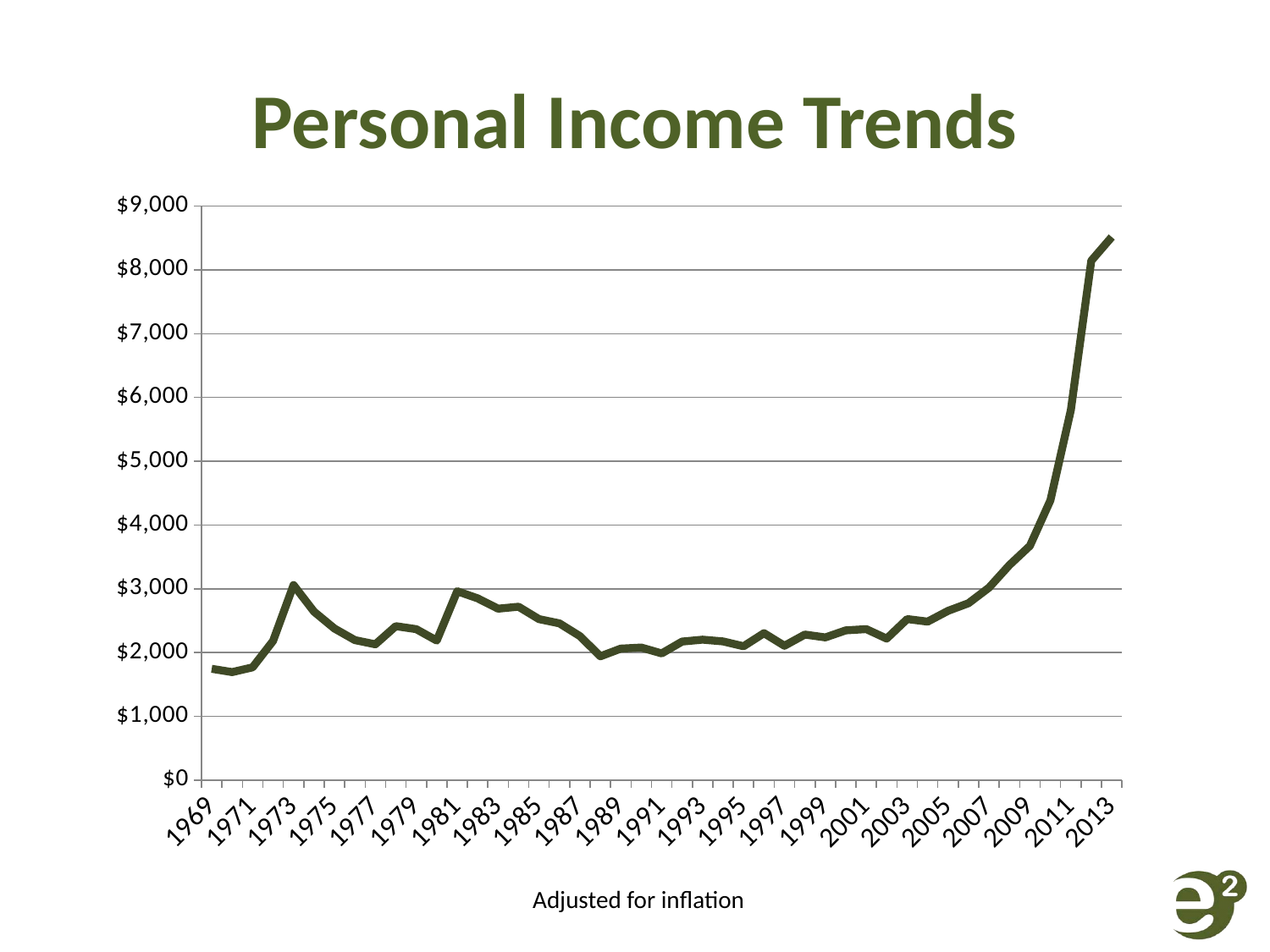
Which is larger, the value for 2013 or the value for 1969? 2013 What kind of chart is shown on the slide? line chart Is the value for 2011 greater or less than $5,000? greater Is the value for 1969 greater or less than $2,000? less Is the value for 1977 greater or less than $3,000? less What is the title of the chart? Personal Income Trends Do the values rise or fall from 2005 to 2013? rise What is the highest value shown on the y axis? $9,000 Which year has the highest personal income value on the chart? 2013 What note appears below the chart's x axis? Adjusted for inflation